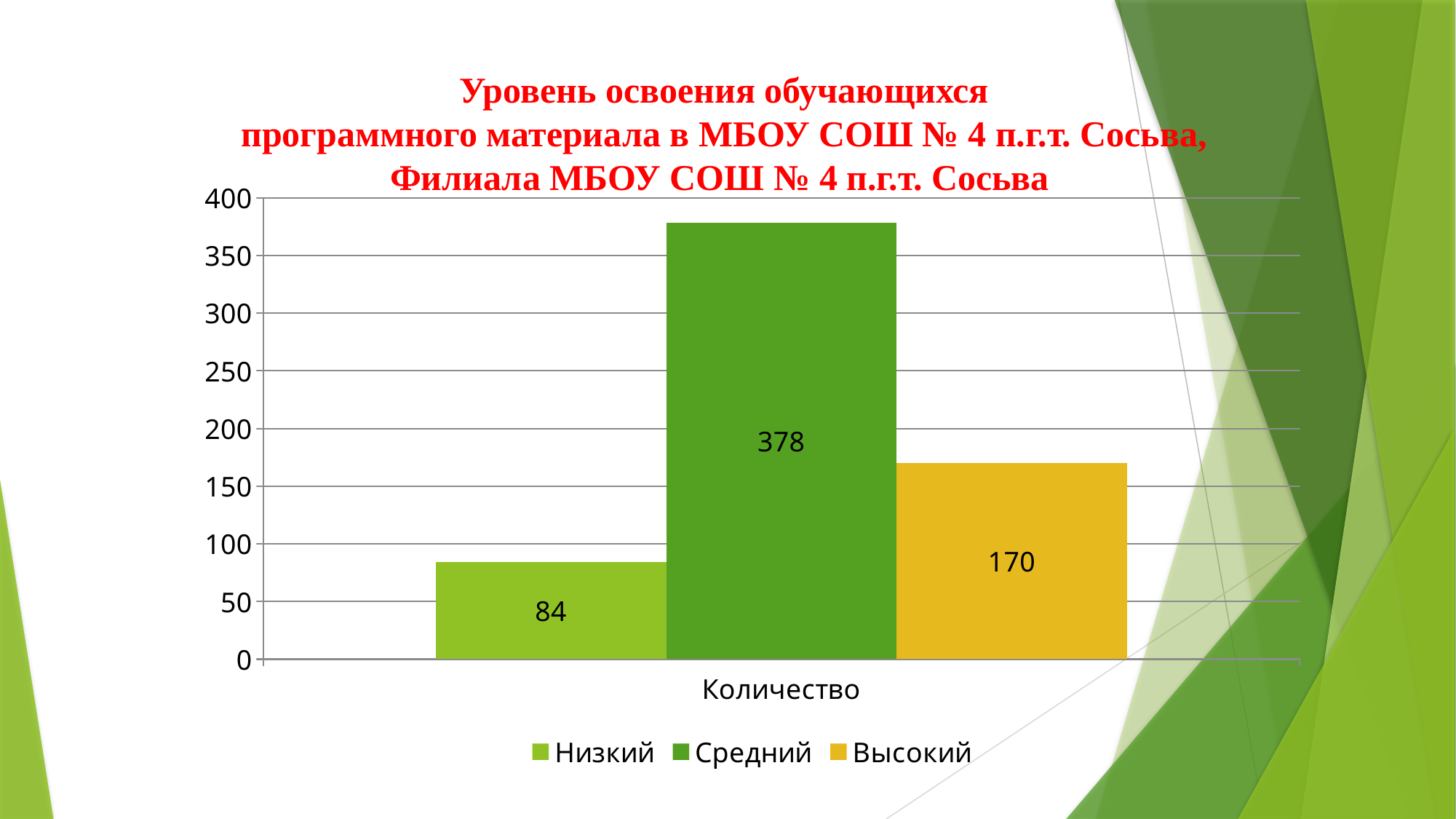
What is the difference between the values for Высокий and Низкий? 86 What kind of chart is shown on the slide? bar chart What is the value for Высокий? 170 What is the label on the x axis category? Количество Which series has the lowest value? Низкий What is the difference between the values for Средний and Высокий? 208 Is the value for Средний greater or less than 350? greater Which is larger, the value for Высокий or the value for Низкий? Высокий What is the value for Низкий? 84 How many series does the legend list? 3 What is the value for Средний? 378 Which series has the highest value? Средний